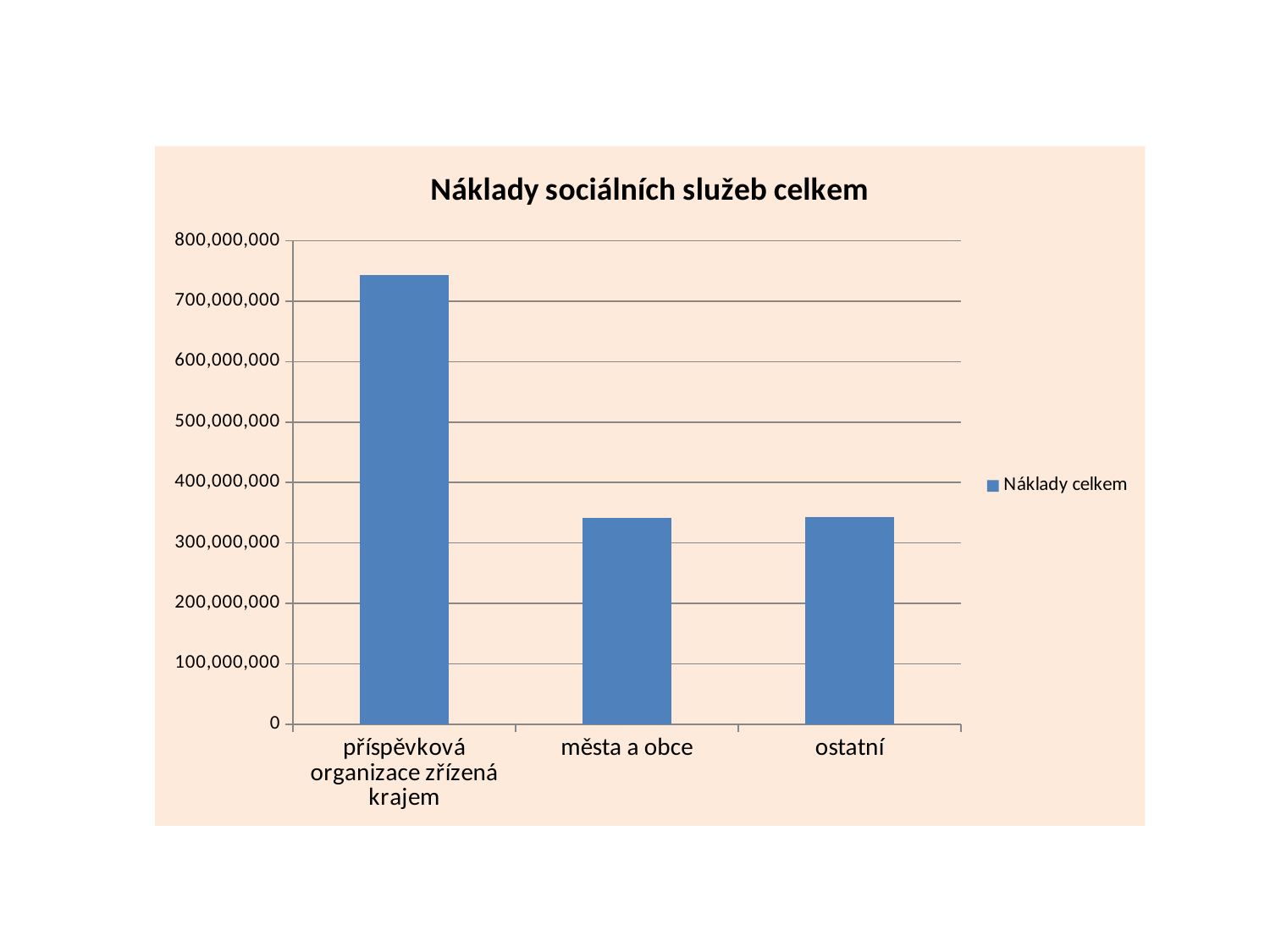
How many categories are shown on the x axis of the chart? 3 Which category has the highest value? příspěvková organizace zřízená krajem Is the value for příspěvková organizace zřízená krajem greater or less than 700,000,000? greater Is the value for města a obce greater or less than 300,000,000? greater What kind of chart is shown on the slide? bar chart Is the value for města a obce greater or less than 400,000,000? less How many series does the legend list? 1 What is the name of the series shown in the legend? Náklady celkem What is the title of the chart? Náklady sociálních služeb celkem Which is larger, the value for příspěvková organizace zřízená krajem or the value for města a obce? příspěvková organizace zřízená krajem